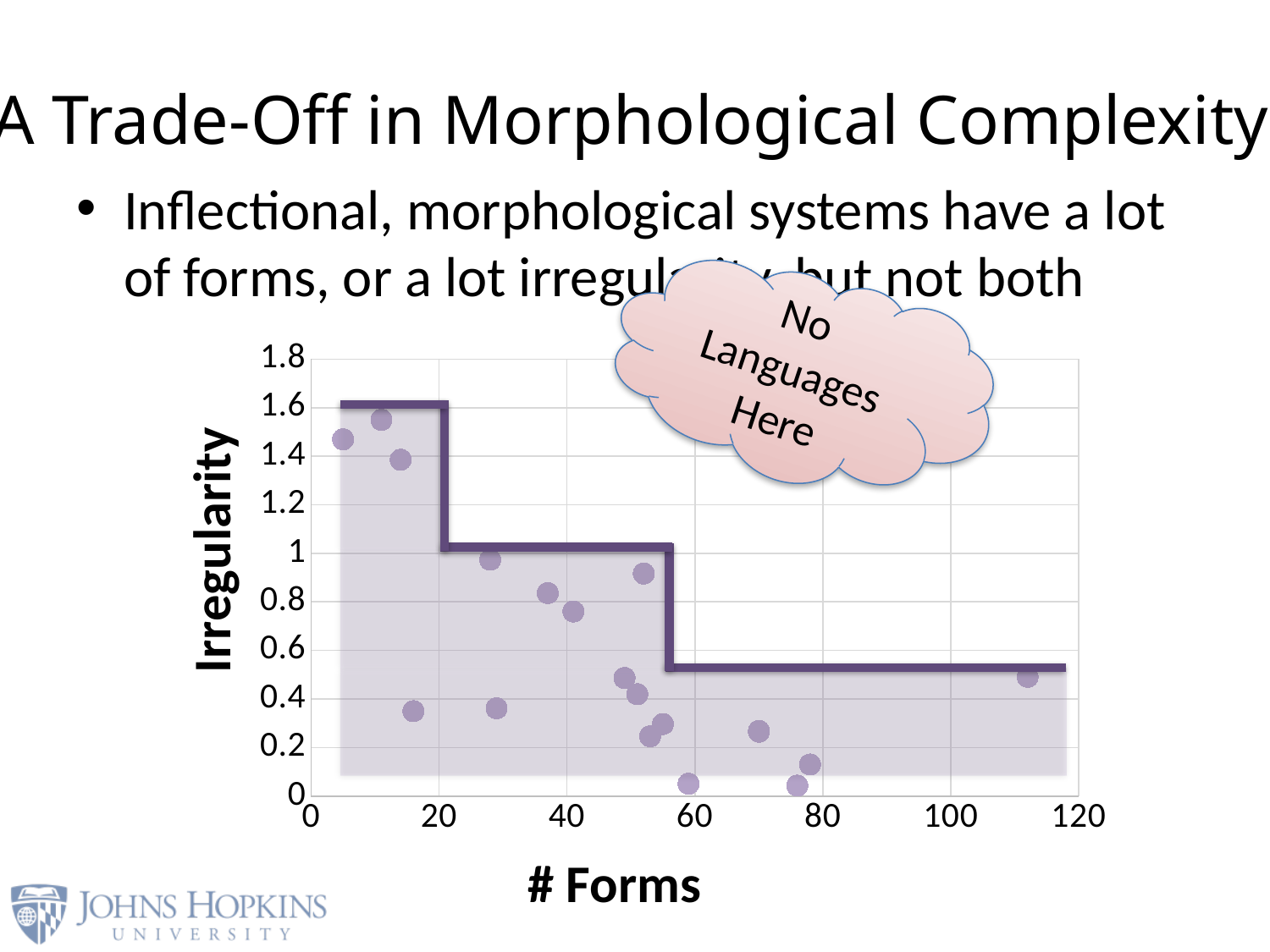
Is the irregularity of the highest point on the chart greater or less than 1.4? greater What is the label of the y axis of the chart? Irregularity As the number of forms increases along the x axis, does irregularity generally rise or fall? fall Is the number of forms for the rightmost point greater or less than 100? greater Is the irregularity of the lowest point on the chart greater or less than 0.2? less What kind of chart is shown on the slide? scatter chart Which has higher irregularity: the point with the most forms or the point with the fewest forms? the point with the fewest forms What is the label of the x axis of the chart? # Forms